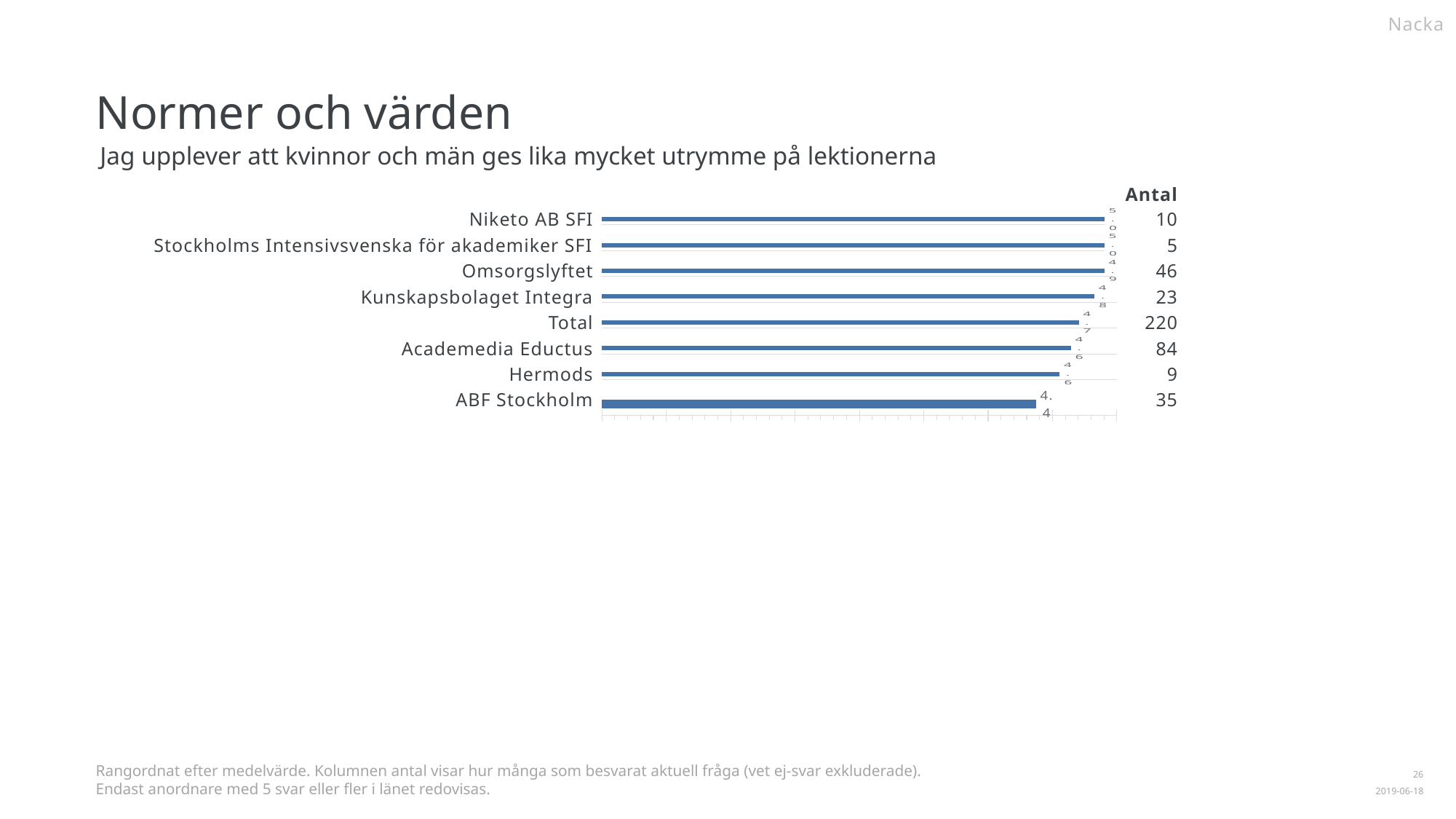
Is the bar for Omsorgslyftet longer or shorter than the bar for ABF Stockholm? longer What is the Antal value shown for Hermods? 9 What is the Antal value shown for Omsorgslyftet? 46 What is the difference between the Antal values for Omsorgslyftet and Kunskapsbolaget Integra? 23 Excluding Total, which provider has the highest Antal value? Academedia Eductus What is the subtitle (survey statement) shown above the chart? Jag upplever att kvinnor och män ges lika mycket utrymme på lektionerna Which provider has the lowest Antal value in the Antal column? Stockholms Intensivsvenska för akademiker SFI What is the Antal value shown for Total? 220 What is the Antal value shown for Academedia Eductus? 84 How many categories (bars) does the chart show? 8 What kind of chart is shown on the slide? bar chart Which category has the shortest bar in the chart? ABF Stockholm